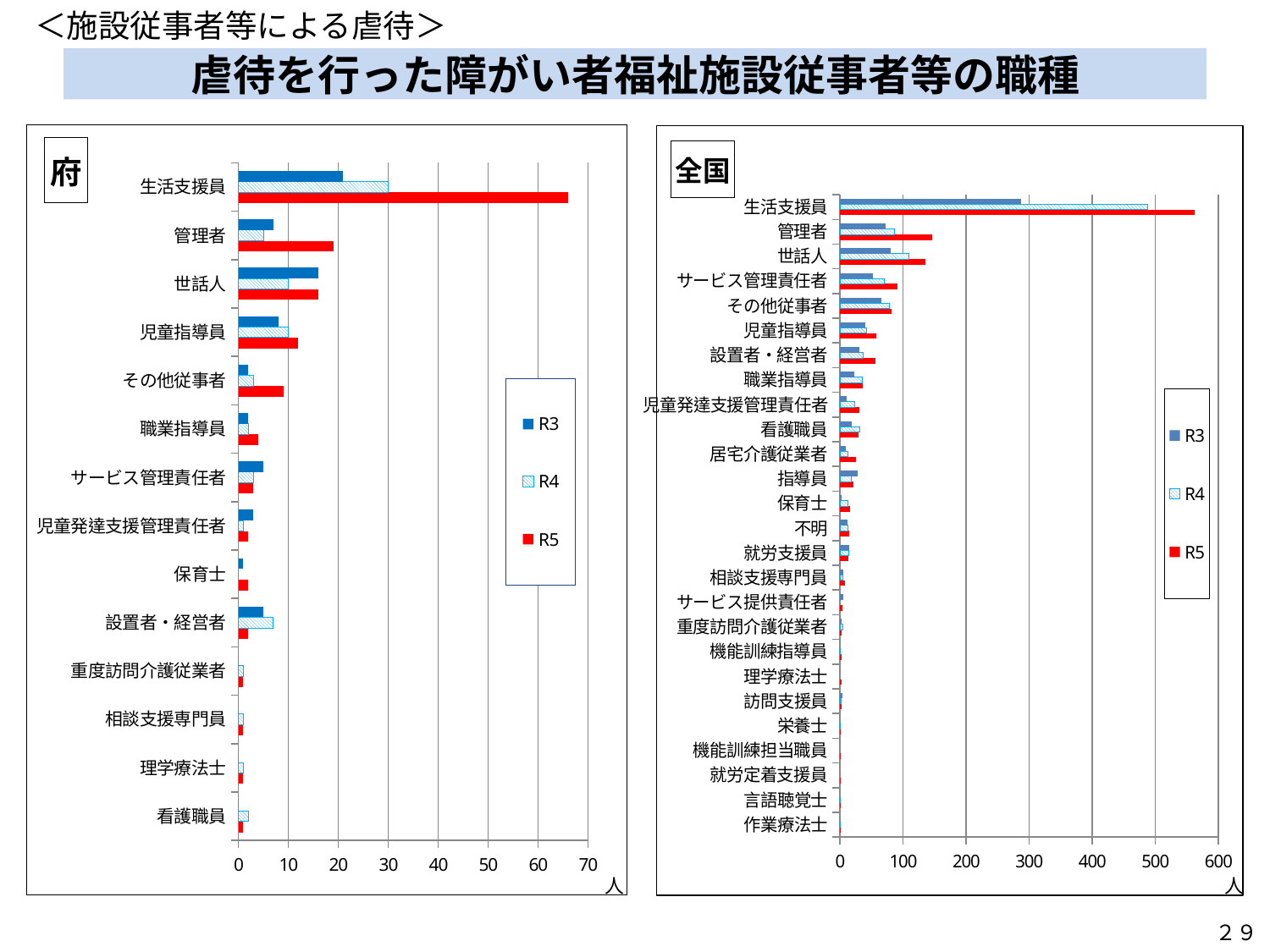
In the 府 chart, which category has the highest R5 value? 生活支援員 In the 全国 chart, which is larger for 生活支援員: the R4 value or the R5 value? R5 What are the legend entries of the 府 chart? R3, R4, R5 In the 全国 chart, is the R5 value for 生活支援員 greater or less than 500? greater In the 府 chart, is the R5 value for 生活支援員 greater or less than 60? greater In the 府 chart, which is larger for 管理者: the R3 value or the R5 value? R5 How many job categories are shown on the 全国 chart? 26 How many job categories are shown on the 府 chart? 14 In the 全国 chart, is the R3 value for 生活支援員 greater or less than 300? less How many series does the legend of the 全国 chart list? 3 In the 全国 chart, which category has the highest R5 value? 生活支援員 What kind of chart is the 府 chart on the left? bar chart